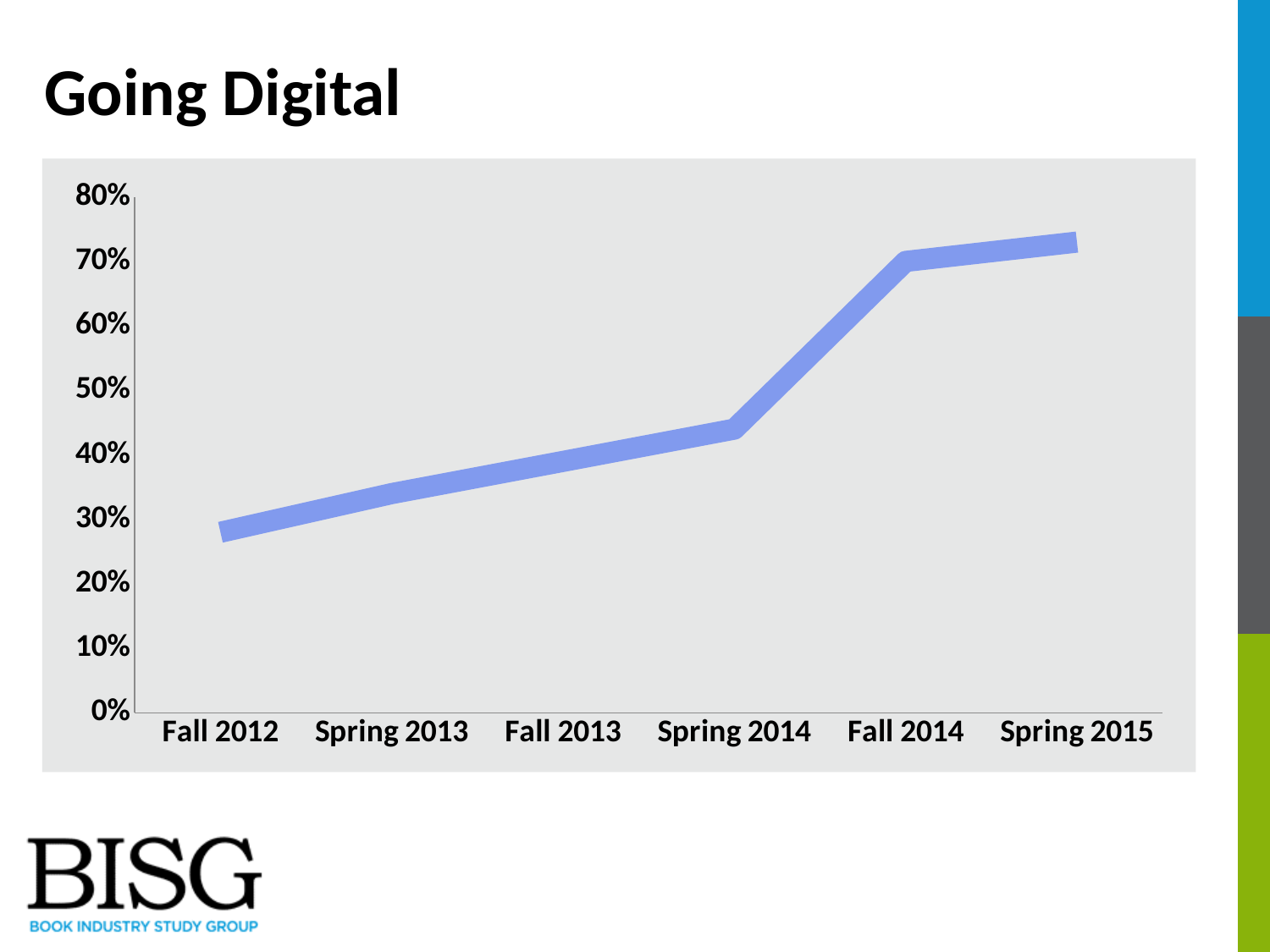
Is the value for Spring 2015 greater or less than 60%? greater Which time point has the lowest value? Fall 2012 What kind of chart is shown on the slide? line chart How many time points are plotted along the x axis? 6 Which is larger, the value for Spring 2014 or the value for Fall 2014? Fall 2014 Is the value for Fall 2012 greater or less than 40%? less What is the title of the slide containing the chart? Going Digital Is the value for Fall 2014 greater or less than 60%? greater Do the values rise or fall from Fall 2012 to Spring 2015? rise